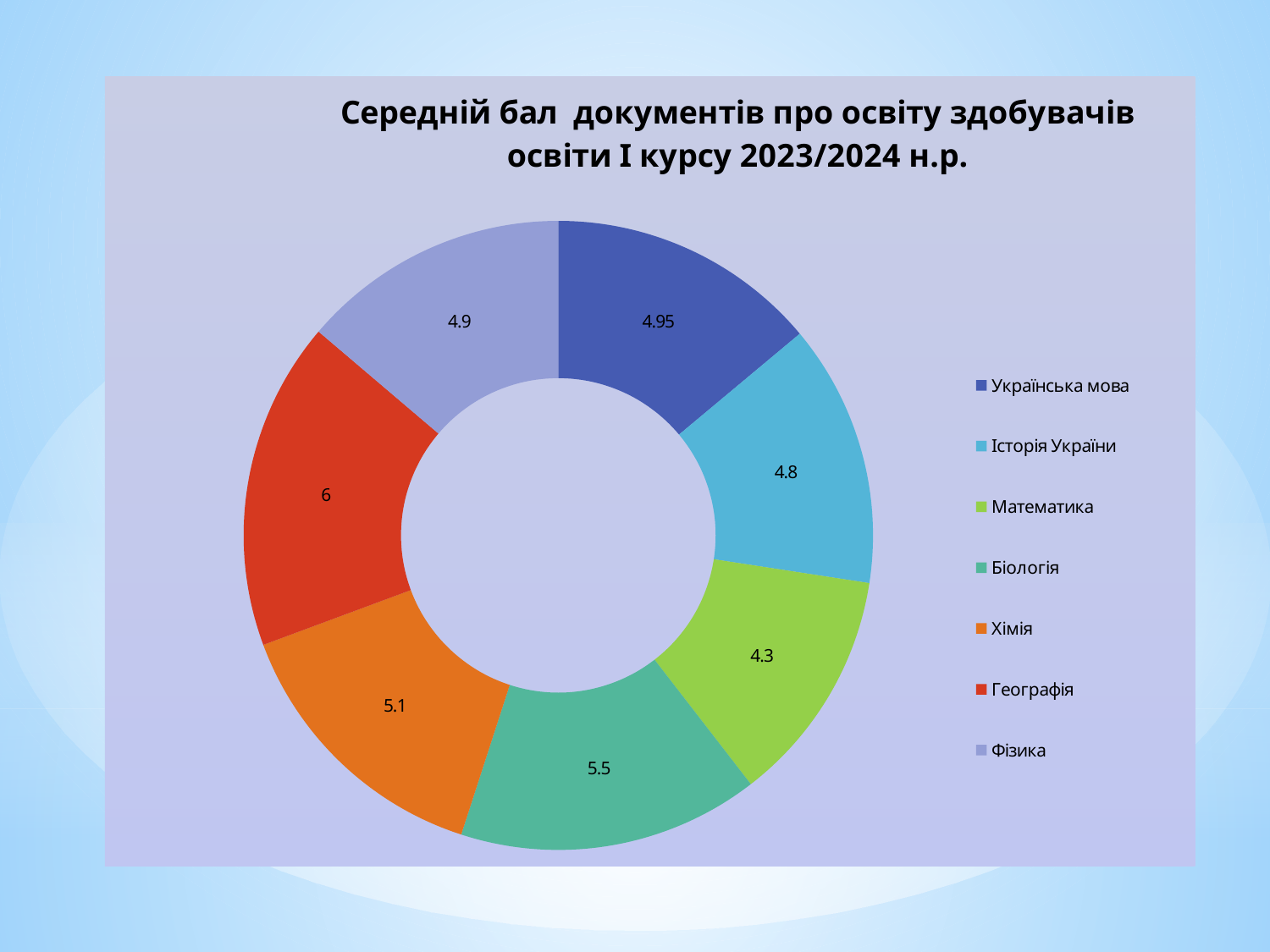
What is the difference between the values for Географія and Математика? 1.7 What colour is the slice for Хімія? Orange What is the value for Українська мова? 4.95 Which is larger, the value for Біологія or the value for Хімія? Біологія What type of chart is shown on the slide? Doughnut (pie) chart What is the value for Математика? 4.3 What is the value for Історія України? 4.8 Which subject has the highest value? Географія Which subject has the lowest value? Математика What is the value for Фізика? 4.9 What is the value for Біологія? 5.5 How many subjects are shown in the chart? 7